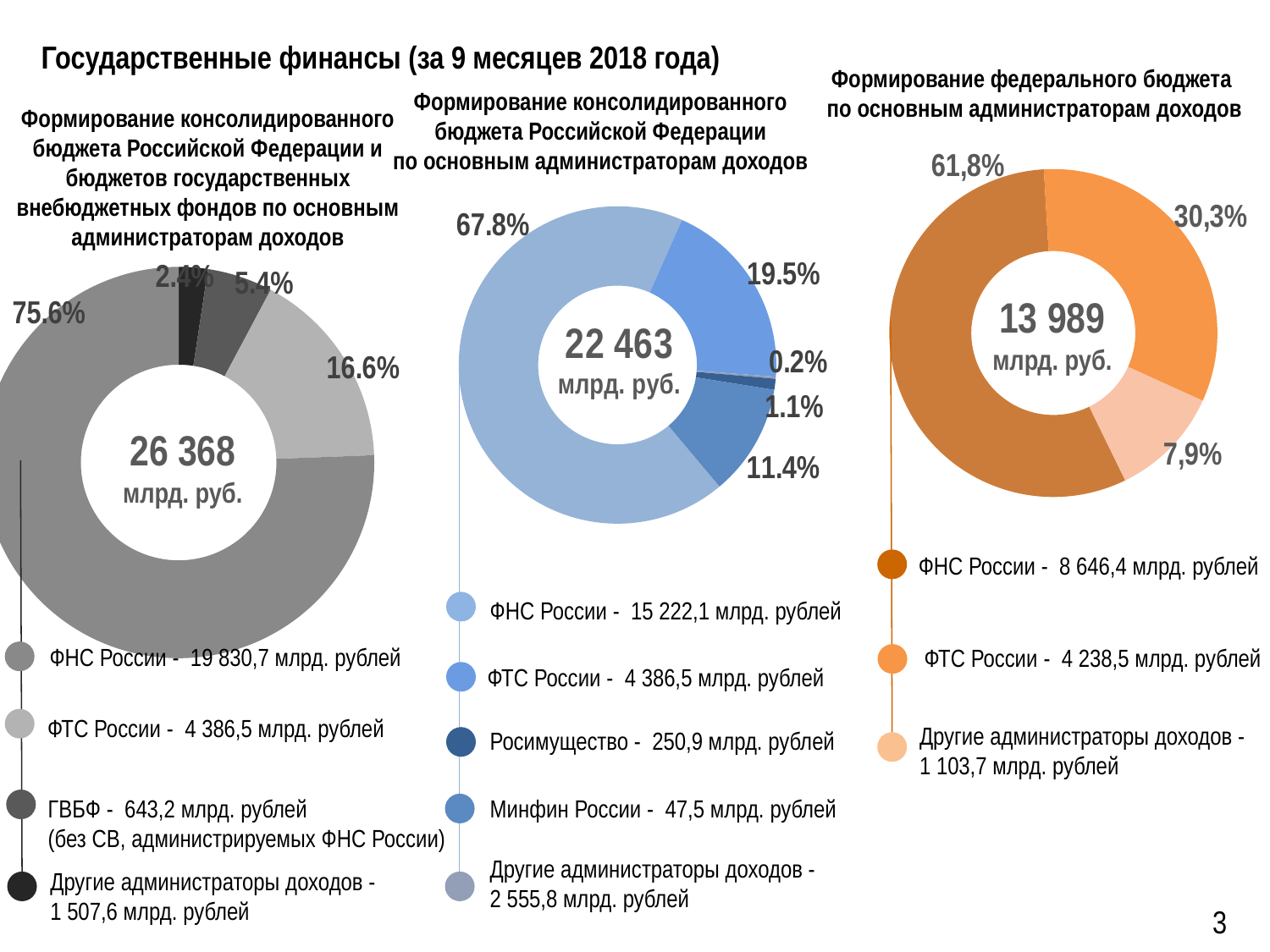
How many categories does the legend of the middle chart (консолидированный бюджет РФ) list? 5 How many categories does the legend of the right chart (федеральный бюджет) list? 3 In the middle chart (консолидированный бюджет РФ), which administrator has the largest share? ФНС России What is the total value shown in the centre of the left chart (консолидированный бюджет и бюджеты ГВБФ)? 26 368 млрд. руб. In the middle chart (консолидированный бюджет РФ), which administrator has the smallest share? Минфин России In the left chart (консолидированный бюджет и бюджеты ГВБФ), which is larger: the value for ГВБФ or the value for Другие администраторы доходов? Другие администраторы доходов In the middle chart (Формирование консолидированного бюджета Российской Федерации по основным администраторам доходов), what value is given for ФНС России in the legend? 15 222,1 млрд. рублей In the left chart (консолидированный бюджет и бюджеты государственных внебюджетных фондов), what share of the total does ФНС России account for? 75.6% What kind of chart is used for the three charts on the slide? Pie (donut) chart In the right chart (Формирование федерального бюджета по основным администраторам доходов), what is the total value shown in the centre of the donut? 13 989 млрд. руб. In the right chart (федеральный бюджет), what is the difference between the values for ФНС России and ФТС России? 4 407,9 млрд. рублей In the right chart (федеральный бюджет), what share does ФТС России account for? 30,3%